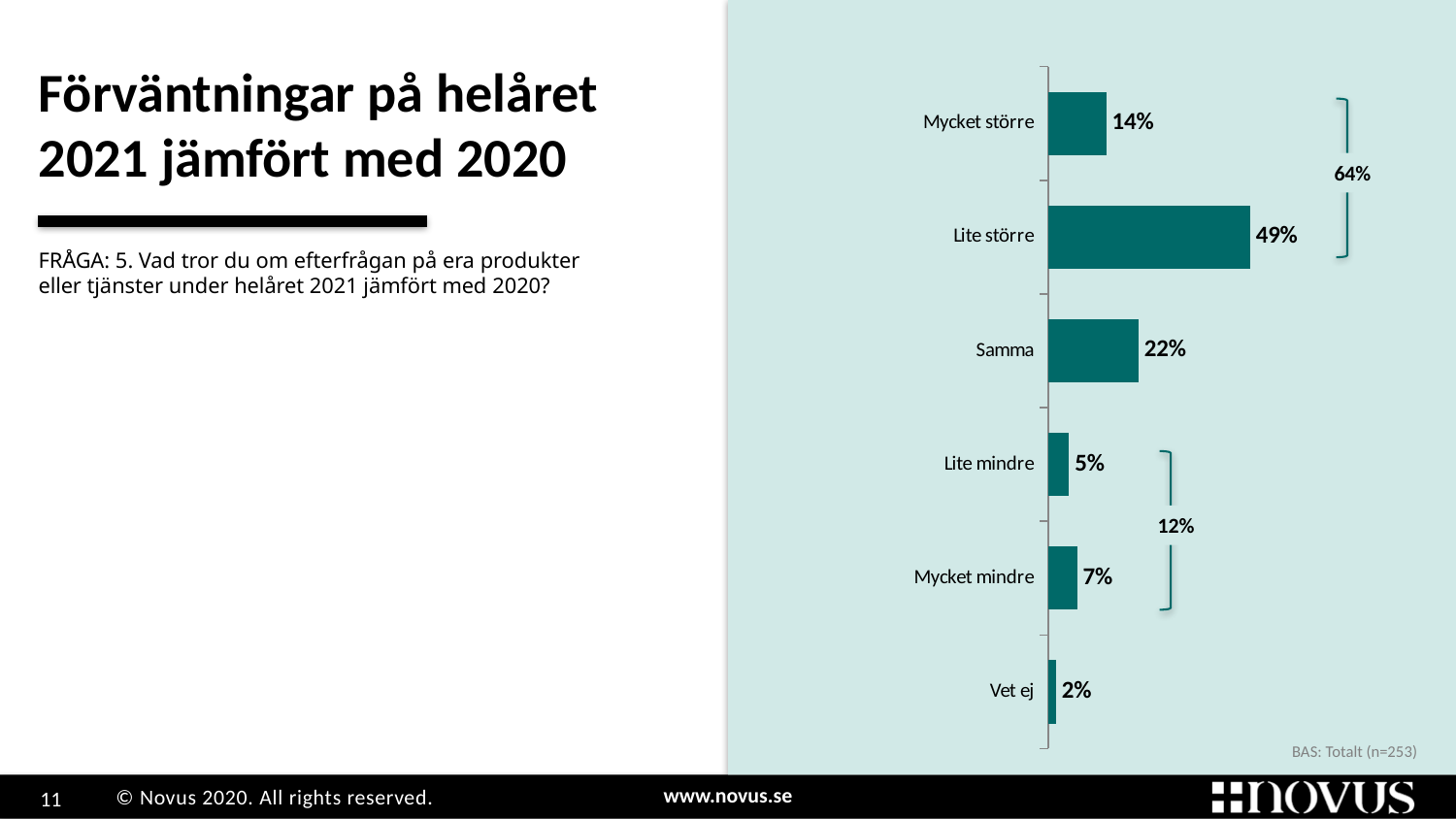
What is the difference between the values for "Lite större" and "Samma"? 27% What is the combined value shown by the bracket for "Mycket större" and "Lite större"? 64% How many categories are shown in the chart? 6 What is the value for "Samma"? 22% What is the value for "Lite större"? 49% What is the value for "Vet ej"? 2% Which category has the highest value? Lite större What is the combined value shown by the bracket for "Lite mindre" and "Mycket mindre"? 12% What is the value for "Mycket större"? 14% Which is larger, the value for "Lite mindre" or "Mycket mindre"? Mycket mindre What kind of chart is shown on the slide? Bar chart Which category has the lowest value? Vet ej